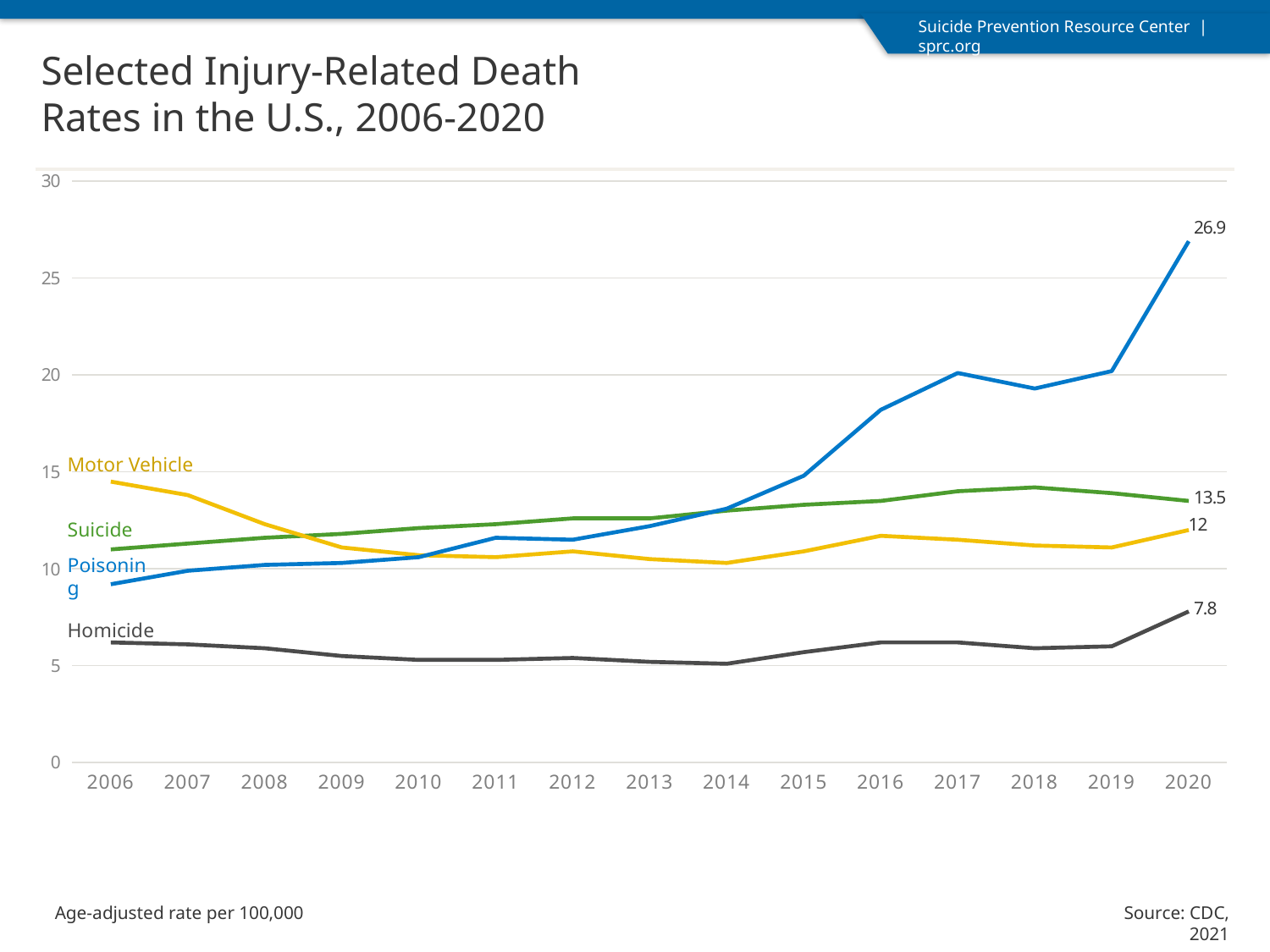
Which cause of death has the lowest rate in 2020? Homicide What is the Suicide death rate in 2020? 13.5 How many years are shown on the x axis? 15 Which cause of death has the highest rate in 2020? Poisoning Is the Poisoning rate in 2006 greater or less than 10? less In 2020, which is larger: the Suicide rate or the Motor Vehicle rate? Suicide What is the Homicide death rate in 2020? 7.8 How many series are plotted on the chart? 4 What is the Poisoning death rate in 2020? 26.9 What is the difference between the Poisoning and Suicide rates in 2020? 13.4 What is the Motor Vehicle death rate in 2020? 12 What kind of chart is shown on the slide? line chart